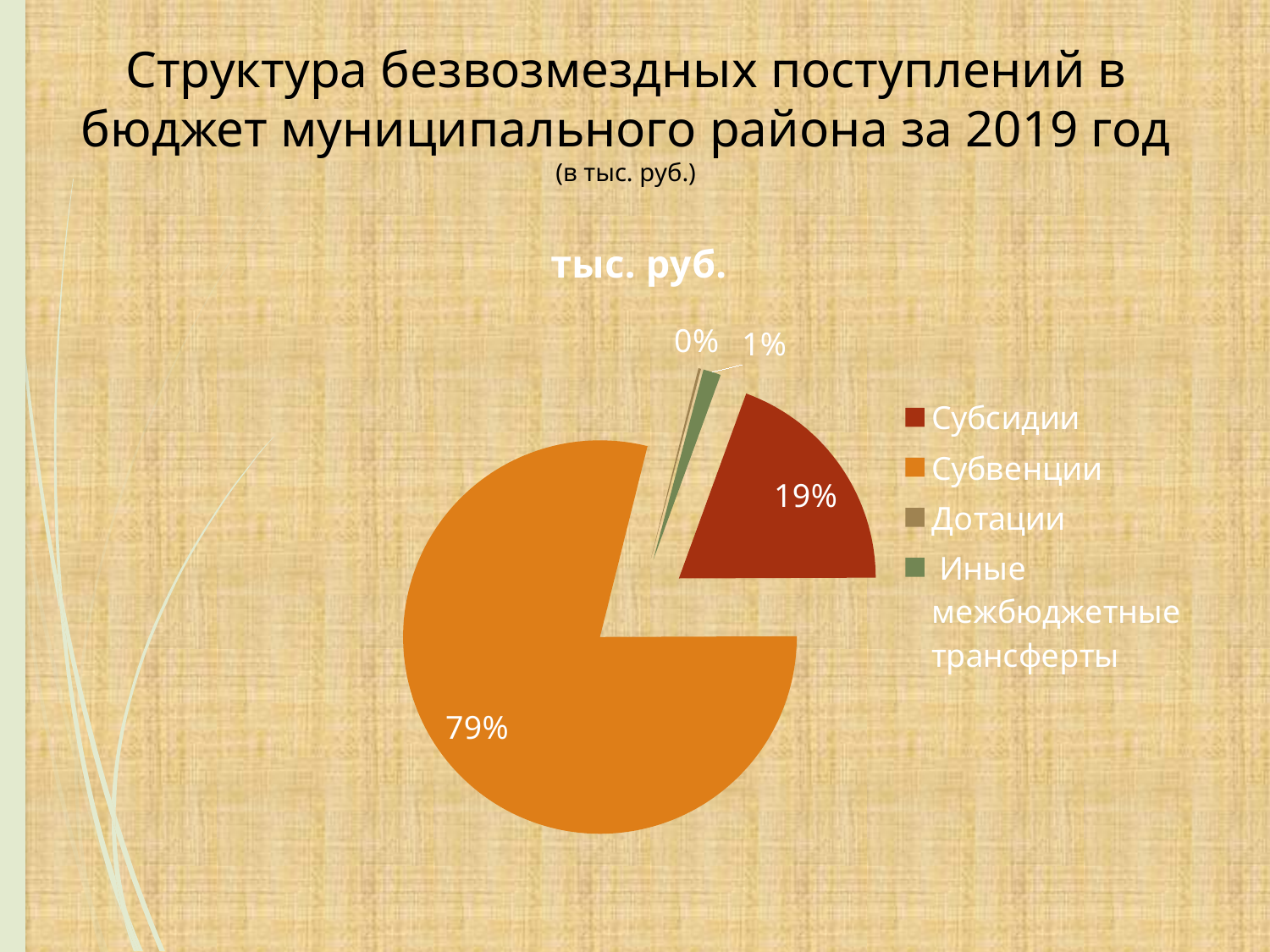
What colour is the slice for Субвенции? orange What share of the pie does Дотации have? 0% What kind of chart is shown on the slide? pie chart What share of the pie does Иные межбюджетные трансферты have? 1% Which is larger, the share for Субсидии or the share for Субвенции? Субвенции Which category has the smallest slice of the pie? Дотации How many categories does the legend list? 4 What share of the pie does Субсидии have? 19% What is the title of the chart? тыс. руб. What is the difference in percentage points between the Субвенции share and the Субсидии share? 60 Which category has the largest slice of the pie? Субвенции